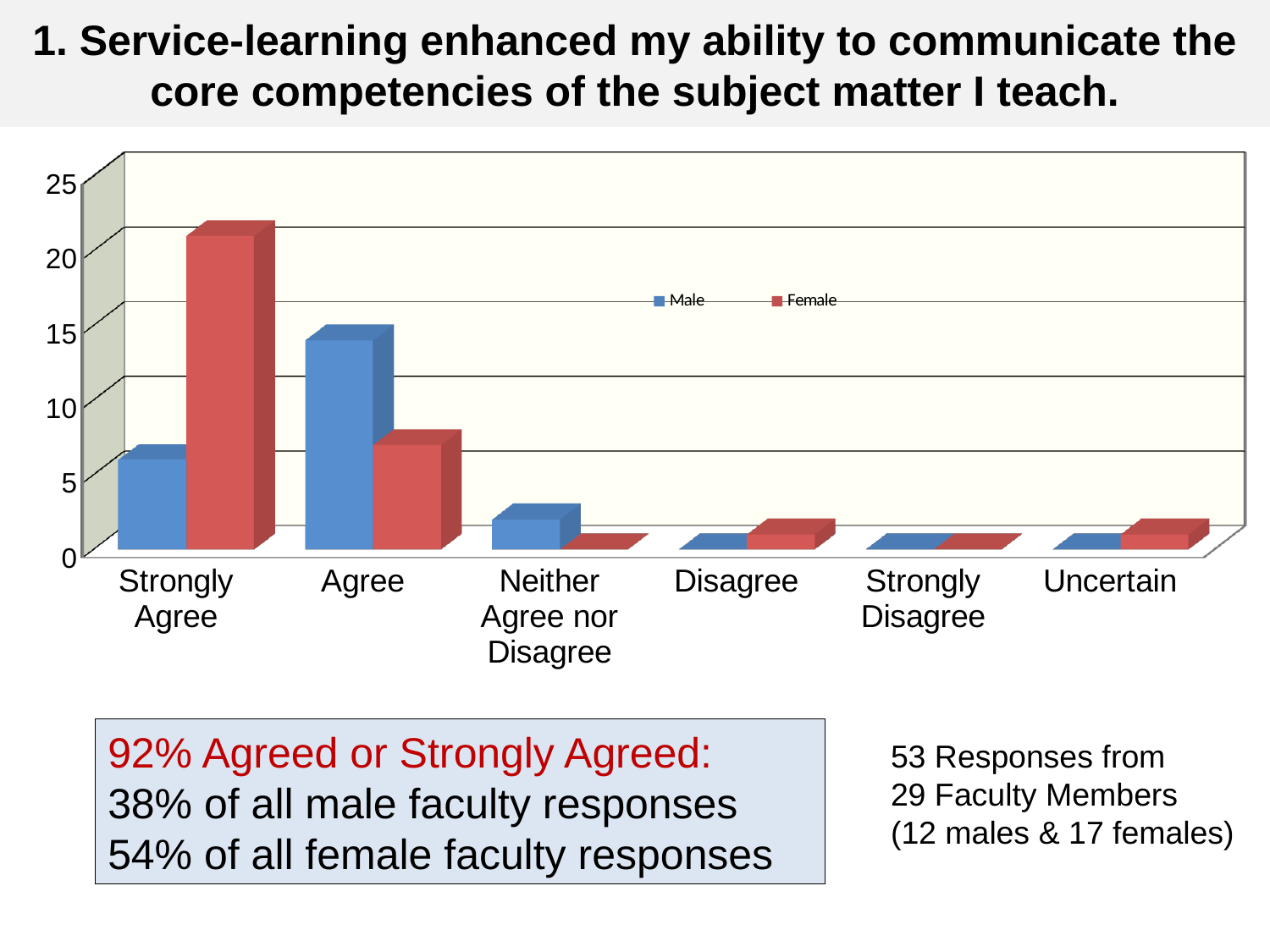
For Agree, which is larger, the Male value or the Female value? Male How many response categories are shown along the x axis? 6 Which colour represents the Female series in the legend? red How many series does the legend list? 2 Which category has the highest Female value? Strongly Agree Is the Male value for Agree greater or less than 10? greater What is the highest value shown on the vertical axis? 25 For Strongly Agree, which is larger, the Male value or the Female value? Female Is the Male value for Strongly Agree greater or less than 10? less What kind of chart is shown on the slide? bar chart Is the Female value for Strongly Agree greater or less than 20? greater Which category has the highest Male value? Agree